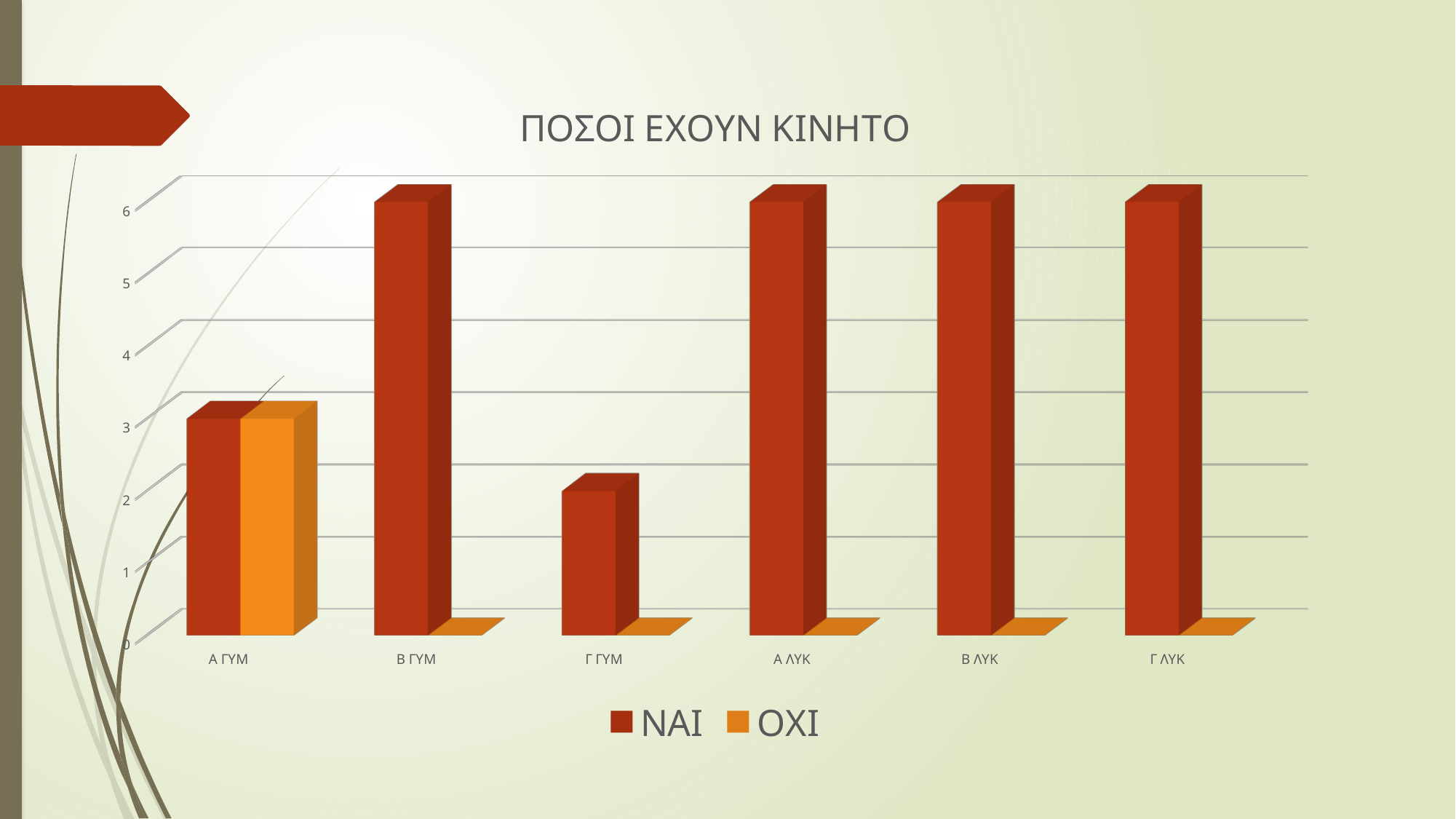
What kind of chart is shown on the slide? bar chart Which series is shown in orange in the legend? ΟΧΙ How many series does the legend list? 2 How many categories are shown on the x axis? 6 Which category has the lowest ΝΑΙ value? Γ ΓΥΜ Which category has the highest ΟΧΙ value? Α ΓΥΜ What is the title of the chart? ΠΟΣΟΙ ΕΧΟΥΝ ΚΙΝΗΤΟ Is the ΝΑΙ value for Α ΓΥΜ greater or less than 5? less Which is larger, the ΝΑΙ value for Α ΛΥΚ or the ΝΑΙ value for Γ ΓΥΜ? Α ΛΥΚ Is the ΝΑΙ value for Γ ΓΥΜ greater or less than 4? less Is the ΝΑΙ value for Β ΓΥΜ greater or less than 4? greater Which is larger, the ΝΑΙ value for Α ΓΥΜ or the ΝΑΙ value for Β ΓΥΜ? Β ΓΥΜ